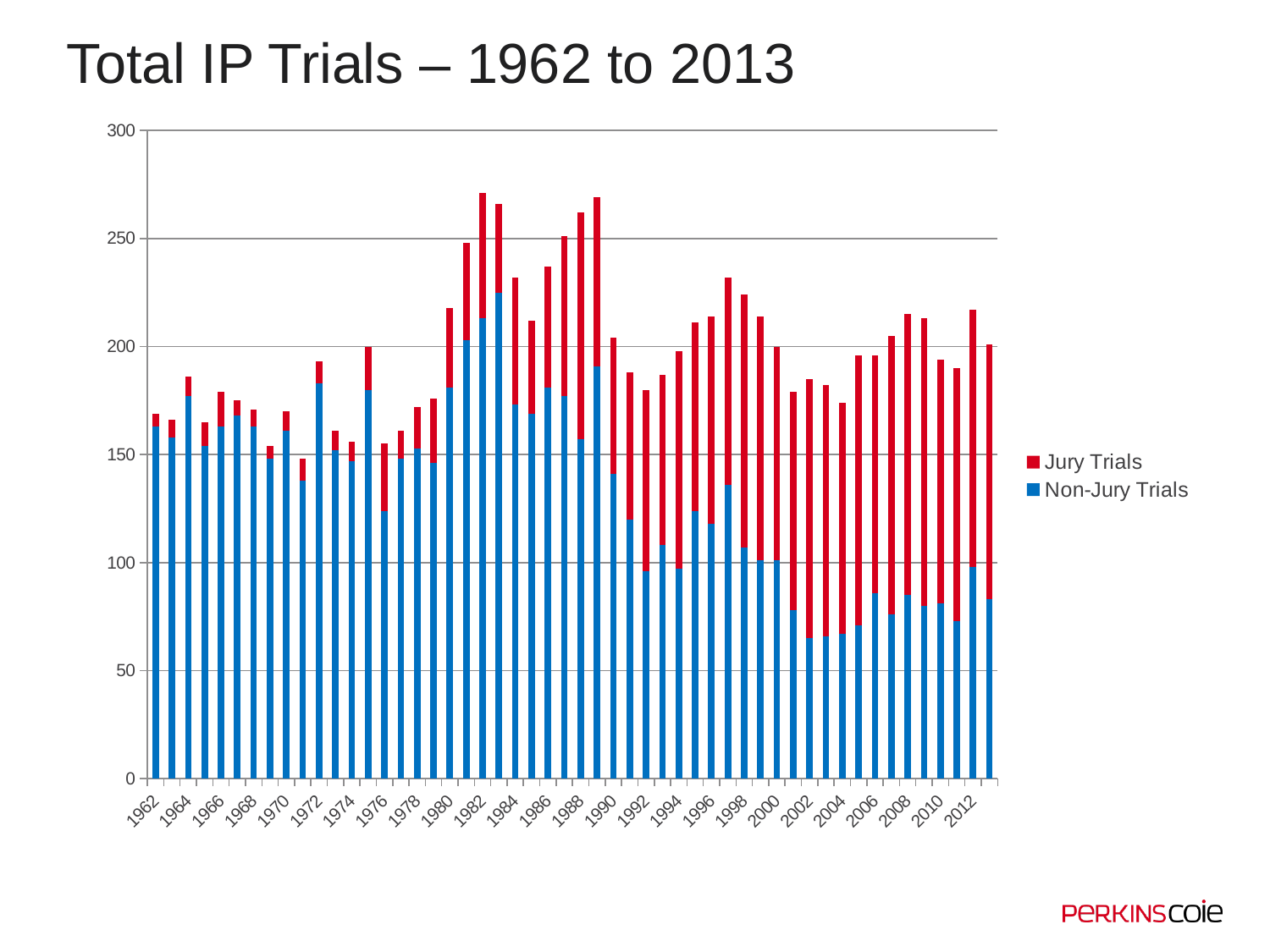
Which colour represents Non-Jury Trials? Blue What are the two series named in the legend? Jury Trials and Non-Jury Trials Which is larger in 2003: Jury Trials or Non-Jury Trials? Jury Trials Do Non-Jury Trials generally rise or fall from 1990 to 2003? Fall How many series does the legend list? 2 Is the number of Non-Jury Trials in 1983 greater or less than 200? greater How many years (bars) are plotted in the chart? 52 Is the total number of IP trials in 1982 greater or less than 250? greater Is the number of Non-Jury Trials in 2003 greater or less than 100? less Which year has the larger total number of IP trials, 1962 or 1982? 1982 What kind of chart is shown on the slide? Stacked bar chart